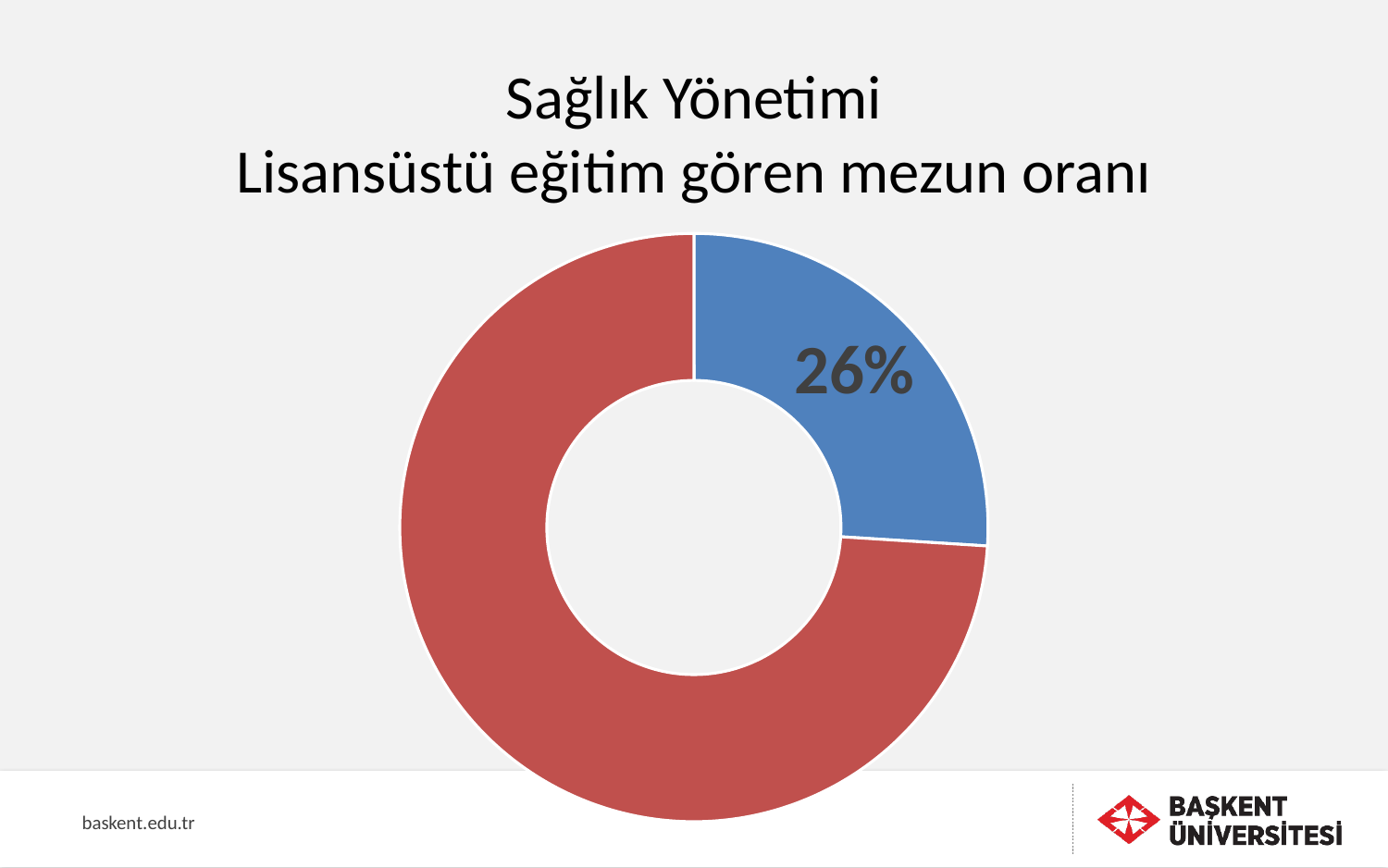
What colour is the slice labelled 26%? Blue What percentage is shown on the blue slice of the chart? 26% What kind of chart is shown on the slide? Doughnut (pie) chart What is the title of the chart? Sağlık Yönetimi Lisansüstü eğitim gören mezun oranı Which slice is larger, the blue one or the red one? The red one How many slices does the doughnut chart have? 2 Which slice of the chart is the smallest? The blue slice (26%) What share of the doughnut does the blue slice represent? 26%